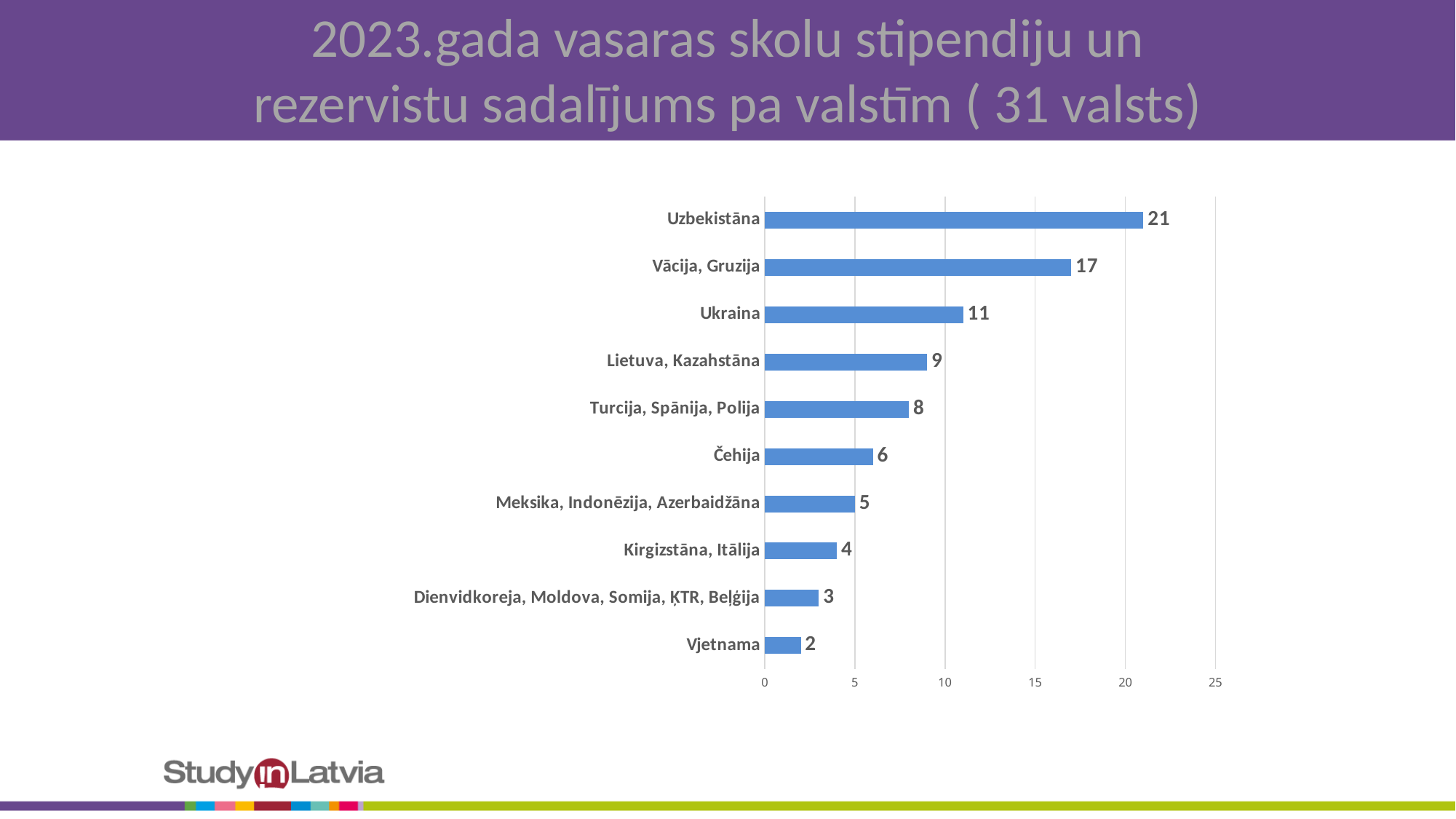
What is the difference between the values for Uzbekistāna and Vācija, Gruzija? 4 How many categories are shown in the chart? 10 What is the value for Čehija? 6 What is the value for Uzbekistāna? 21 Which category has the highest value? Uzbekistāna Is the value for Vācija, Gruzija greater or less than 15? greater What is the value for Dienvidkoreja, Moldova, Somija, ĶTR, Beļģija? 3 What is the value for Ukraina? 11 Which category has the lowest value? Vjetnama What is the difference between the values for Lietuva, Kazahstāna and Turcija, Spānija, Polija? 1 What kind of chart is shown on the slide? bar chart Which is larger, the value for Ukraina or the value for Kirgizstāna, Itālija? Ukraina